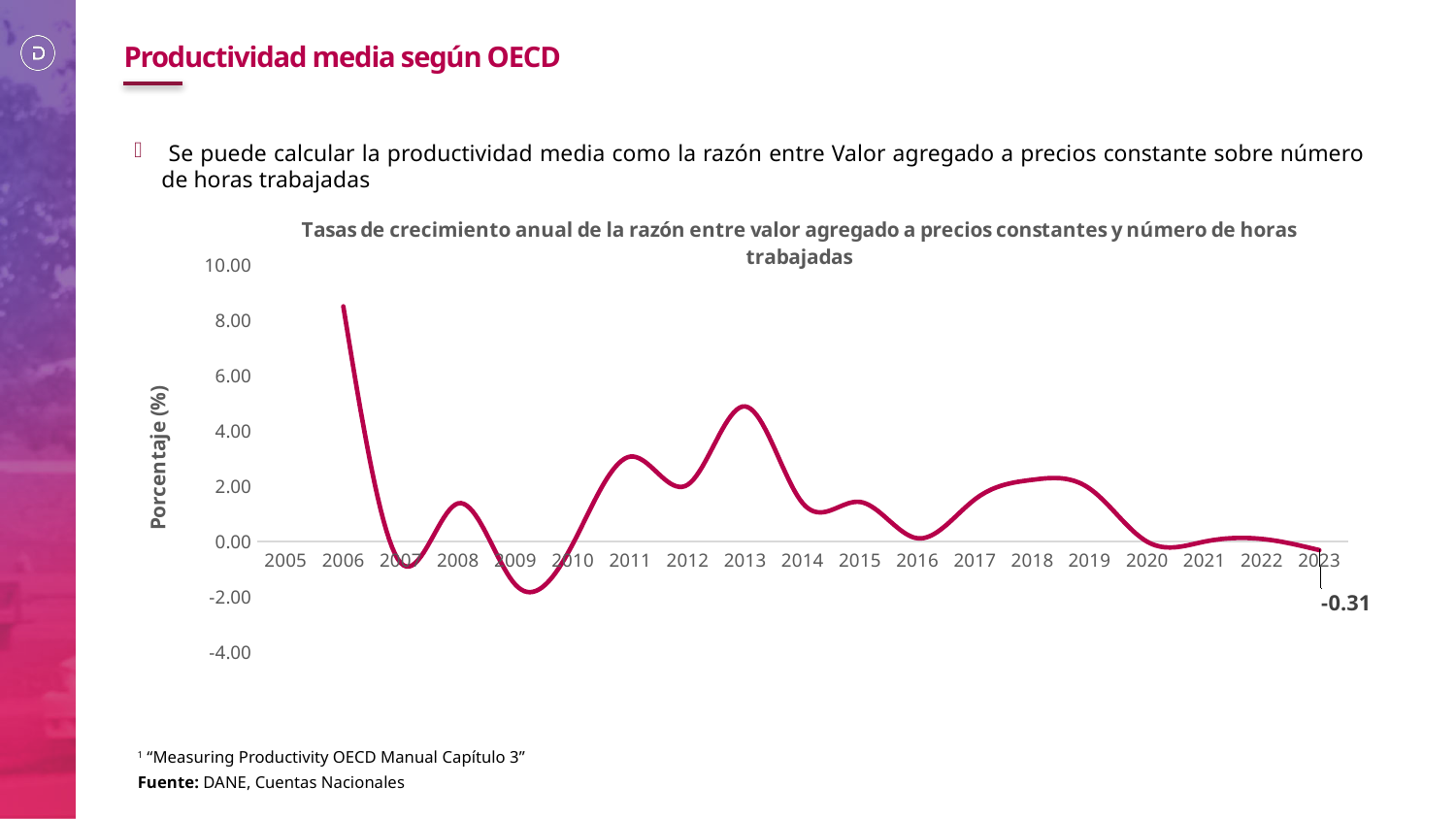
What kind of chart is shown on the slide? line chart Is the value for 2006 greater or less than 6.00? greater Which year has the lowest value on the chart? 2009 Is the value for 2016 greater or less than 2.00? less What is the label of the vertical axis? Porcentaje (%) How many year labels are shown on the x axis? 19 Which year has the highest value on the chart? 2006 What is the value shown for 2023? -0.31 Is the value for 2009 greater or less than 0.00? less Which year has the larger value, 2011 or 2013? 2013 Does the line rise or fall between 2006 and 2007? fall